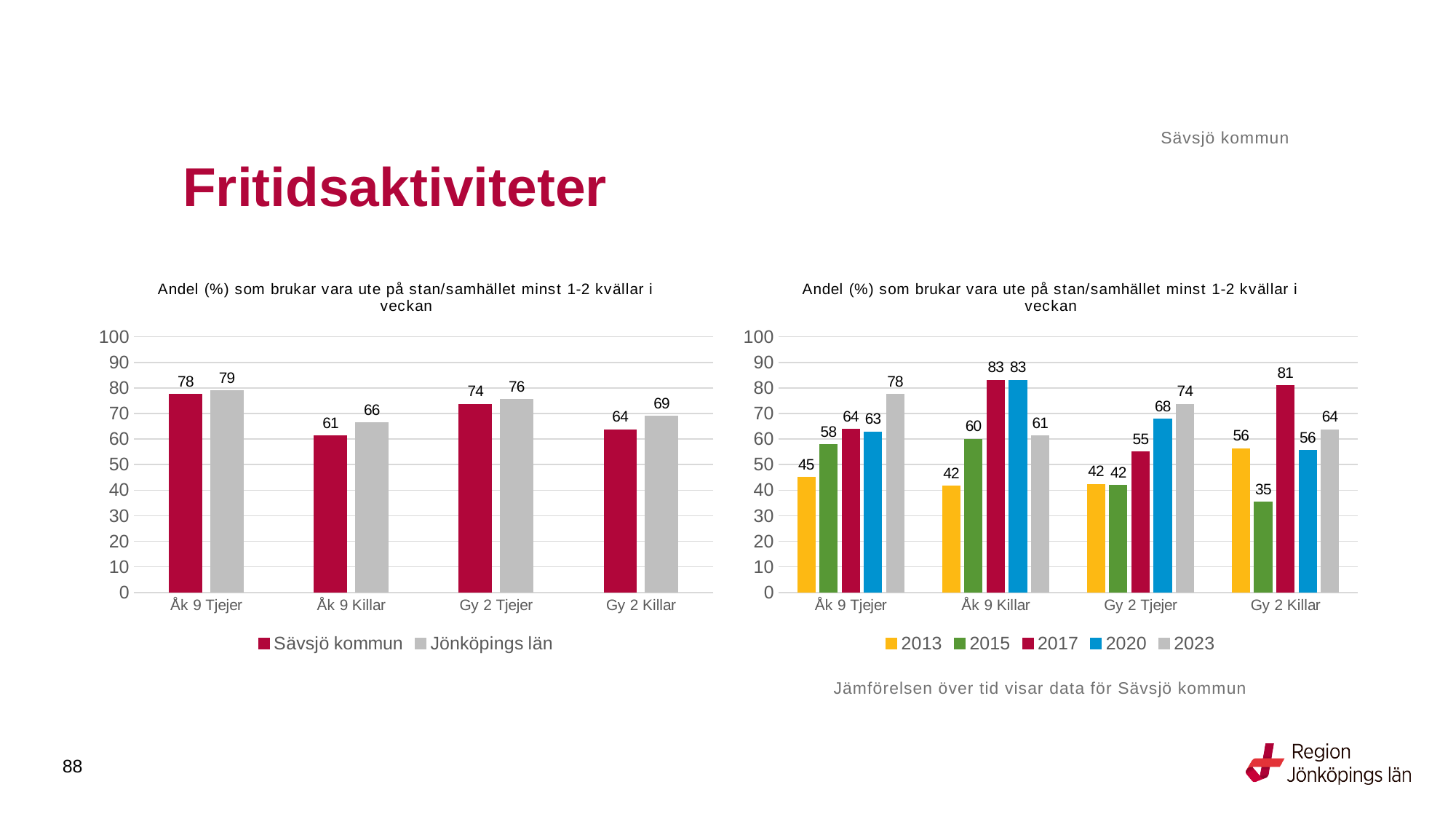
In the right chart, which year has the lowest value for Gy 2 Killar? 2015 In the right chart, which is larger for Gy 2 Tjejer: 2020 or 2023? 2023 In the left chart, what is the value for Jönköpings län for Gy 2 Killar? 69 In the left chart, what is the difference between Jönköpings län and Sävsjö kommun for Åk 9 Killar? 5 What type of chart is the right chart? Bar chart In the left chart, which category has the lowest value for Sävsjö kommun? Åk 9 Killar In the right chart, what is the difference between the 2023 and 2013 values for Åk 9 Tjejer? 33 In the right chart, what is the value for 2017 for Gy 2 Killar? 81 In the left chart, how many series does the legend list? 2 In the left chart, what is the value for Sävsjö kommun for Åk 9 Tjejer? 78 In the right chart, how many series does the legend list? 5 In the right chart, what is the value for 2013 for Åk 9 Tjejer? 45